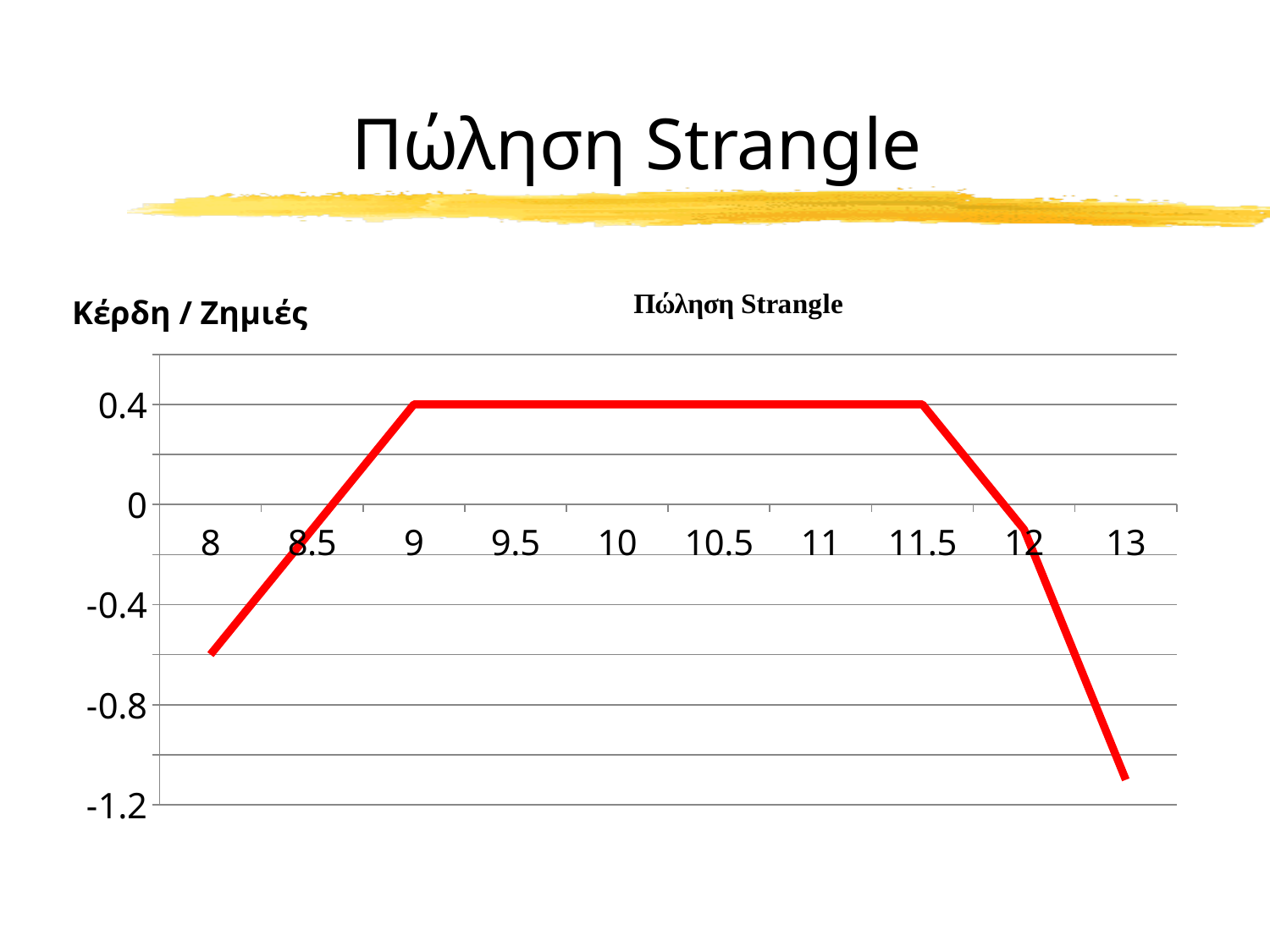
Does the line rise or fall between x = 11.5 and x = 13? fall What label is shown for the vertical axis of the chart? Κέρδη / Ζημιές What is the value of the line at x = 10? 0.4 Is the value at x = 13 greater or less than -0.8? less Which has the larger value, x = 8 or x = 13? 8 What is the value of the line at x = 11? 0.4 Is the value at x = 12 greater or less than -0.4? greater Is the value at x = 8 greater or less than -0.4? less How many x-axis categories are plotted on the chart? 10 What kind of chart is shown on the slide? line chart At which x value is the line at its lowest point? 13 What is the title of the chart? Πώληση Strangle